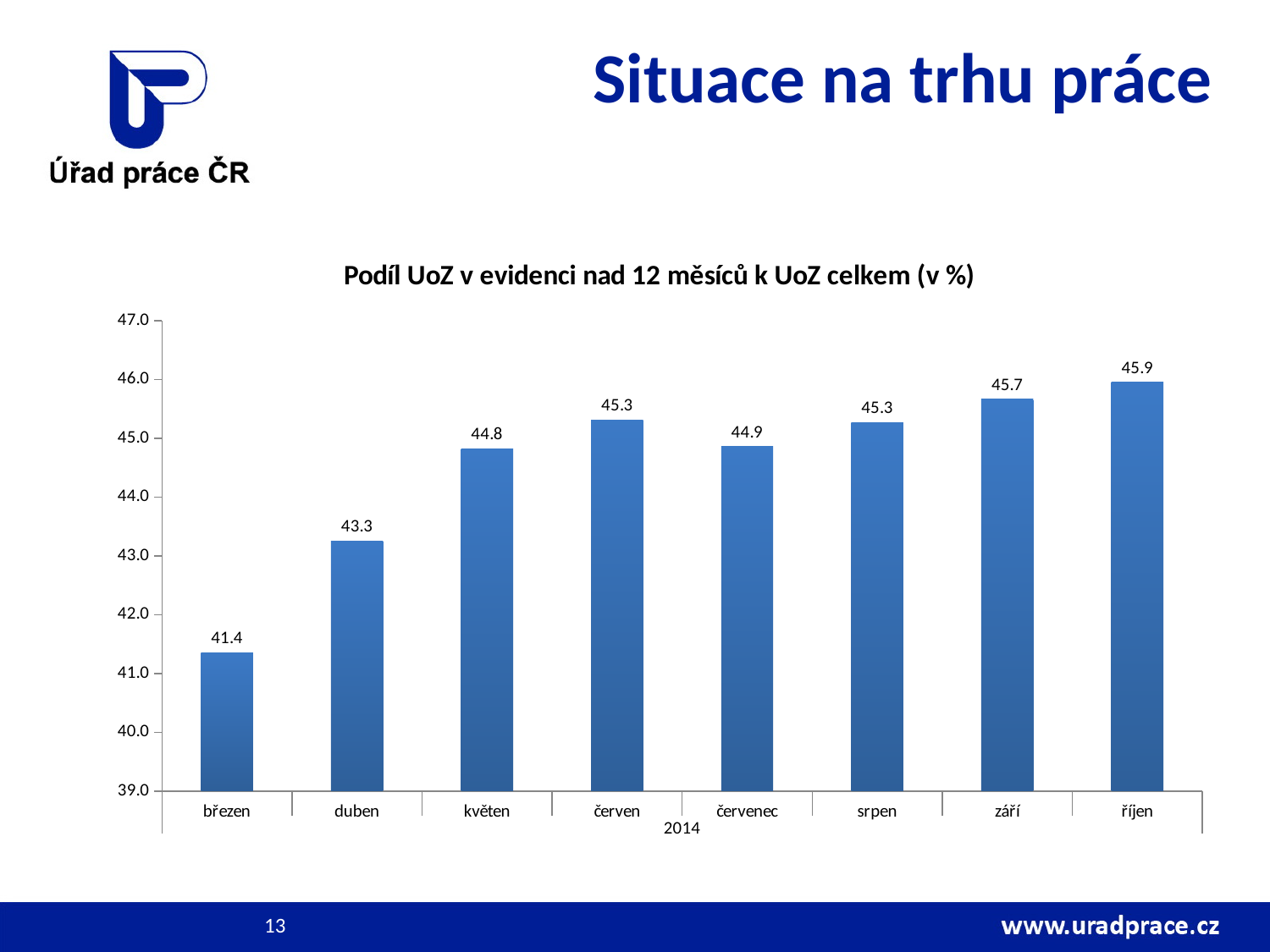
Which is larger, the value for duben or the value for srpen? srpen What is the difference between the values for duben and květen? 1.5 What is the difference between the values for říjen and březen? 4.5 What is the value for březen? 41.4 What is the value for září? 45.7 Is the value for duben greater or less than 44.0? less How many months are shown on the x axis? 8 Which month has the lowest value? březen What is the value for červenec? 44.9 What kind of chart is shown on the slide? bar chart What is the title of the chart? Podíl UoZ v evidenci nad 12 měsíců k UoZ celkem (v %) Which month has the highest value? říjen